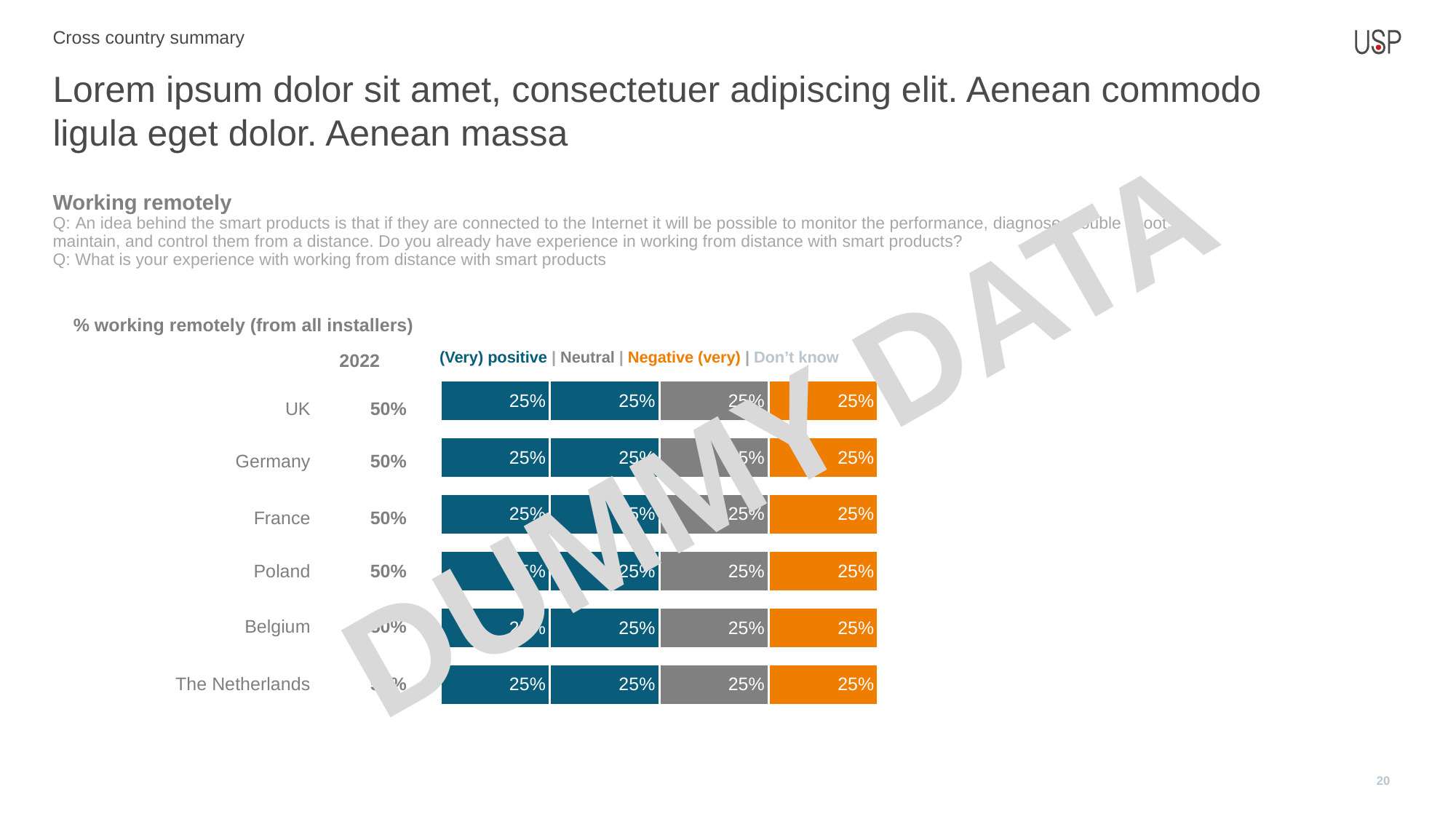
Which country is listed first (at the top) in the chart? UK What is the total of the stacked bar for the UK? 100% How many series does the legend list? 4 Which colour represents 'Negative (very)' in the chart? orange What is the 'Neutral' value for Poland? 25% How many countries are listed in the chart? 6 What is the 2022 percentage working remotely shown for Germany? 50% What is the 'Negative (very)' value for The Netherlands? 25% What is the title of the chart? % working remotely (from all installers) What kind of chart is shown on the slide? bar chart What is the difference between the 'Neutral' value for France and the 'Neutral' value for Belgium? 0%